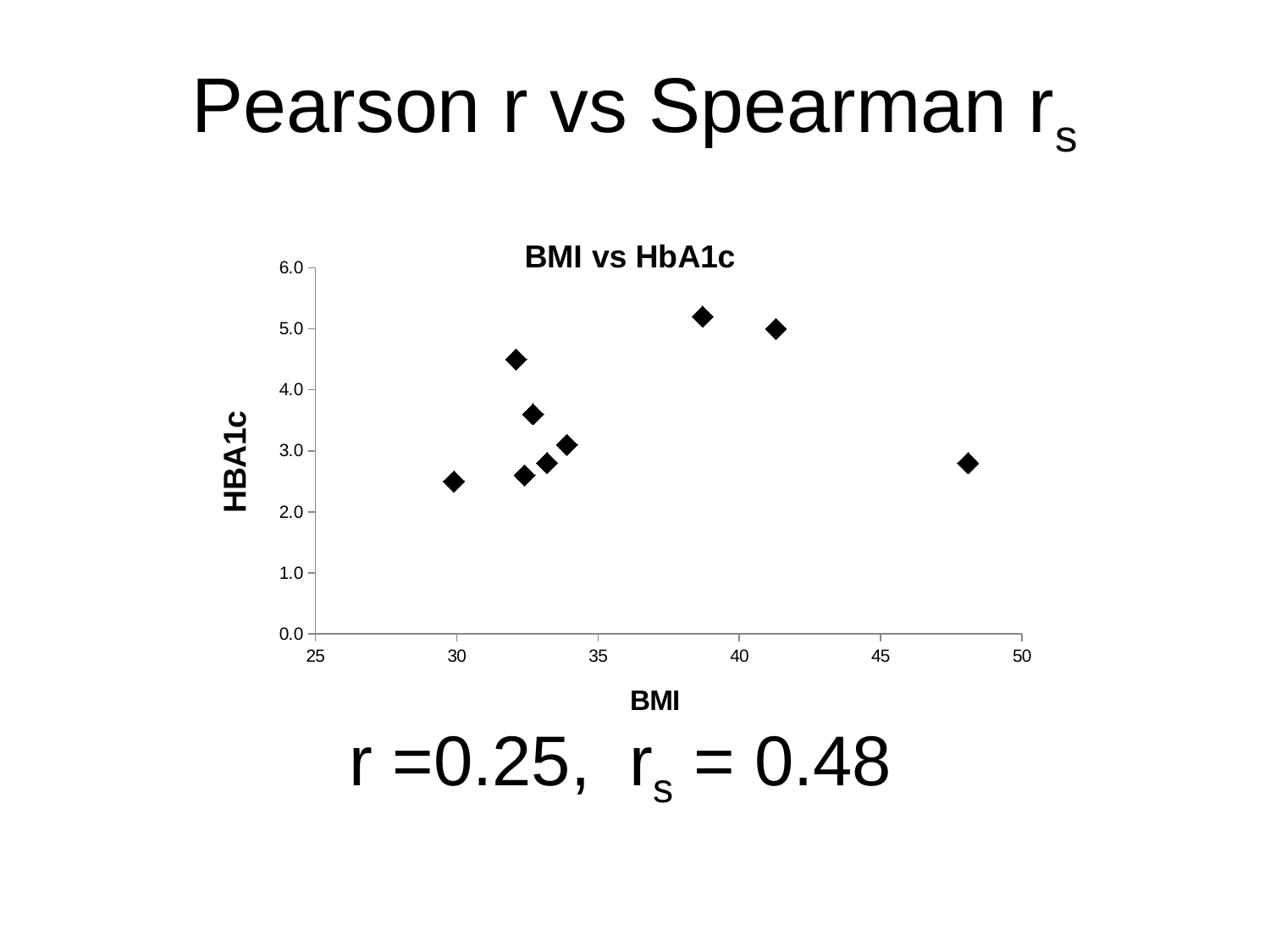
How many points have a BMI greater than 40? 2 Which has the higher HbA1c: the point at BMI near 30 or the point at BMI near 39? the point at BMI near 39 Is the HbA1c of the leftmost point (BMI near 30) greater or less than 3.0? less What is the title of the chart? BMI vs HbA1c Is the HbA1c of the rightmost point (BMI near 48) greater or less than 3.0? less How many points have an HbA1c greater than 4.0? 3 How many data points are plotted in the BMI vs HbA1c chart? 9 What kind of chart is shown on the slide? scatter plot What values of Pearson r and Spearman rs are given below the chart? r = 0.25, rs = 0.48 Is the HbA1c of the point at BMI near 32 with the highest HbA1c greater or less than 4.0? greater